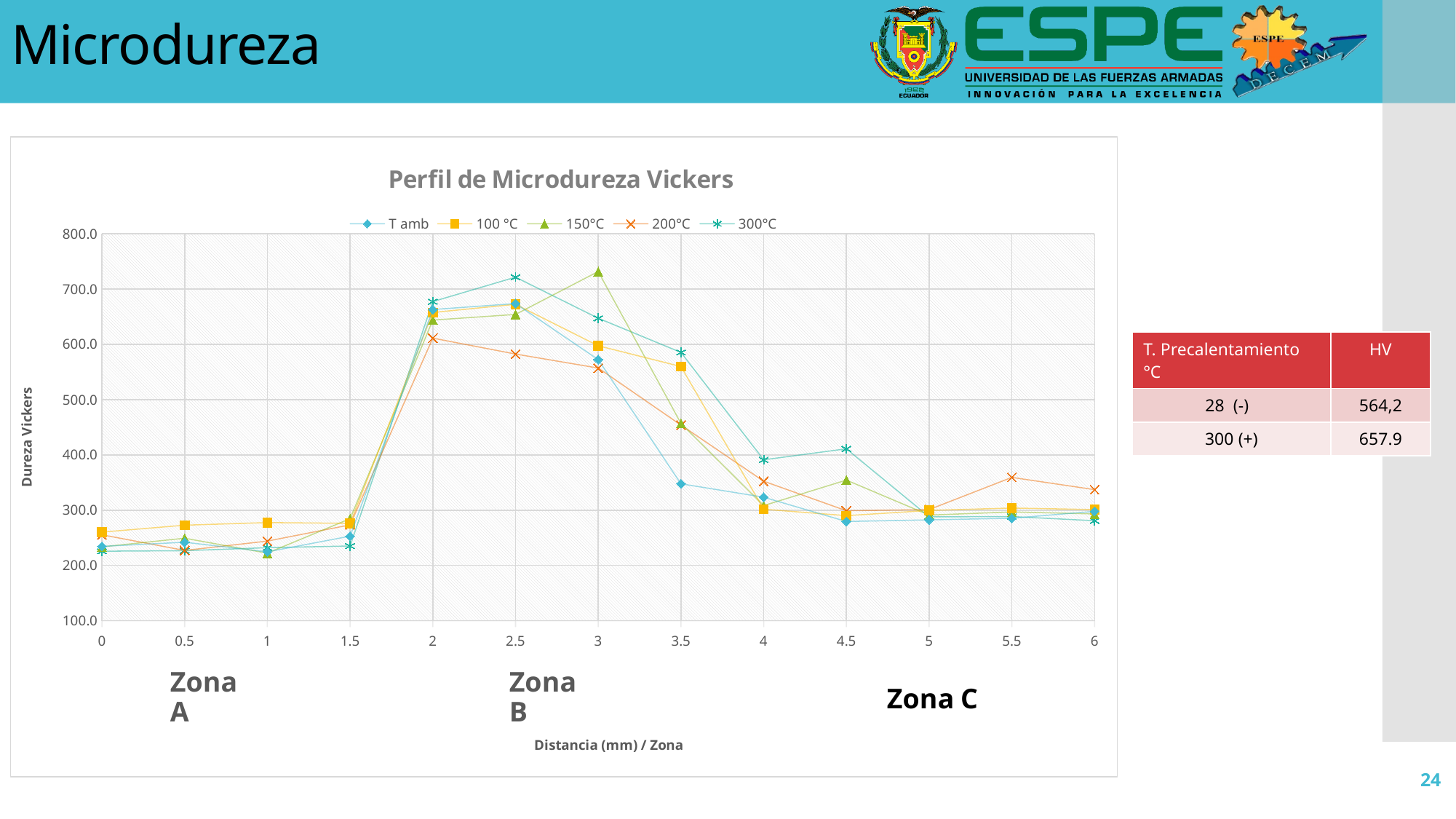
Between distance 3 and distance 4, does the T amb series rise or fall? fall What is the title of the chart? Perfil de Microdureza Vickers Is the value for the 300°C series at distance 2 greater or less than 600? greater At distance 4.5, which series has the larger value, 300°C or 100 °C? 300°C What is the label of the vertical axis of the chart? Dureza Vickers Which series has the highest value at distance 2.5? 300°C What kind of chart is shown on the slide? line chart How many series does the legend of the chart list? 5 Is the value for the T amb series at distance 3.5 greater or less than 400? less Is the value for the 150°C series at distance 3 greater or less than 700? greater How many distance points are plotted along the x axis of the chart? 13 Which series has the highest value at distance 3? 150°C